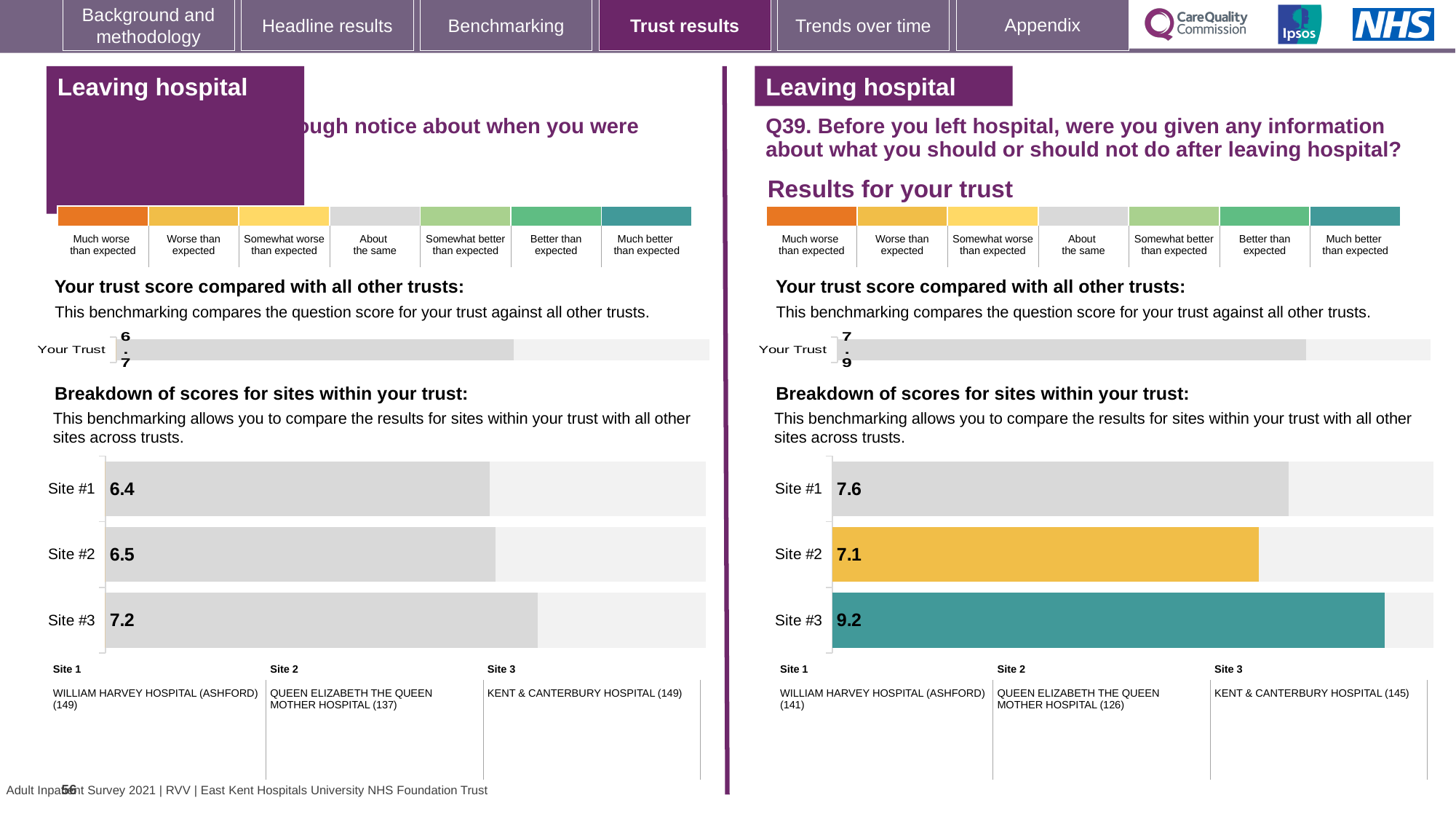
What type of chart is used for the site breakdown on the right-hand (Q39) side? Bar chart In the right-hand (Q39) 'Your trust score compared with all other trusts' chart, what is the score for Your Trust? 7.9 In the right-hand (Q39) site breakdown chart, which site has the lowest score? Site #2 In the right-hand (Q39) site breakdown chart, what is the score for Site #1? 7.6 In the left-hand site breakdown chart, which site has the highest score? Site #3 In the left-hand site breakdown chart, what is the score for Site #2? 6.5 In the left-hand site breakdown chart, what is the difference between the scores for Site #3 and Site #1? 0.8 In the right-hand (Q39) site breakdown chart, what is the difference between the scores for Site #3 and Site #2? 2.1 In the left-hand 'Your trust score compared with all other trusts' chart, what is the score for Your Trust? 6.7 How many sites are shown in the right-hand (Q39) site breakdown chart? 3 In the left-hand site breakdown chart, which is larger: the score for Site #1 or Site #3? Site #3 In the right-hand (Q39) site breakdown chart, what is the score for Site #3? 9.2